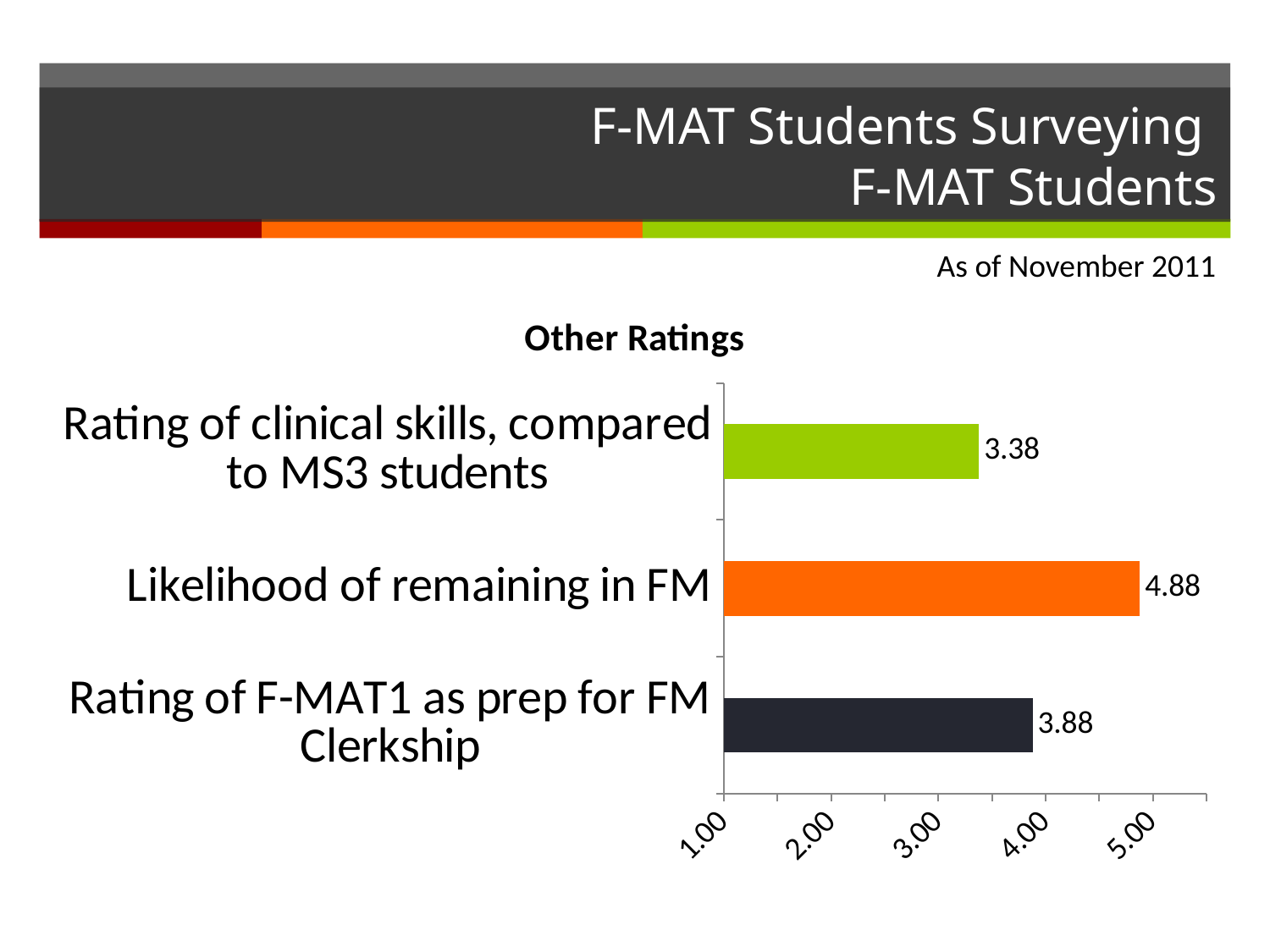
What is the value for 'Likelihood of remaining in FM'? 4.88 Which category has the highest value? Likelihood of remaining in FM What kind of chart is shown on the slide? Bar chart What is the difference between the values for 'Likelihood of remaining in FM' and 'Rating of F-MAT1 as prep for FM Clerkship'? 1.00 What is the difference between the values for 'Rating of F-MAT1 as prep for FM Clerkship' and 'Rating of clinical skills, compared to MS3 students'? 0.50 What is the value for 'Rating of F-MAT1 as prep for FM Clerkship'? 3.88 Which is larger: the value for 'Rating of F-MAT1 as prep for FM Clerkship' or the value for 'Rating of clinical skills, compared to MS3 students'? Rating of F-MAT1 as prep for FM Clerkship Which category has the lowest value? Rating of clinical skills, compared to MS3 students Is the value for 'Likelihood of remaining in FM' greater or less than 4.00? greater What is the value for 'Rating of clinical skills, compared to MS3 students'? 3.38 What is the title of the chart? Other Ratings How many categories are shown in the chart? 3